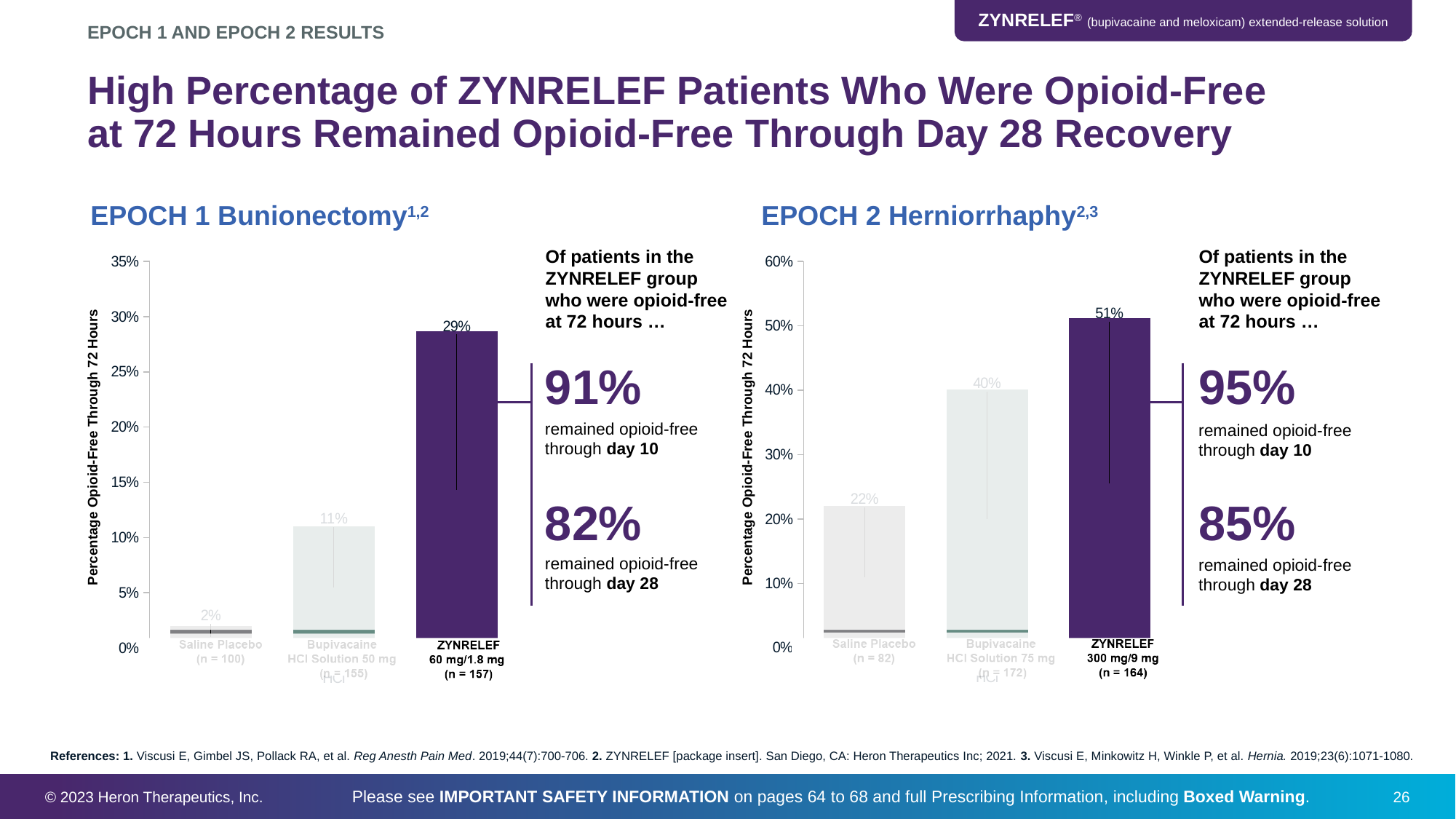
In the EPOCH 1 Bunionectomy chart, what is the difference between the ZYNRELEF group and the Bupivacaine HCl Solution 50 mg group? 18% In the EPOCH 2 Herniorrhaphy chart, what is the difference between the ZYNRELEF group and the Saline Placebo group? 29% In the EPOCH 2 Herniorrhaphy chart, which group has the lowest percentage opioid-free through 72 hours? Saline Placebo In the EPOCH 1 Bunionectomy chart, which group has the highest percentage opioid-free through 72 hours? ZYNRELEF 60 mg/1.8 mg How many groups are plotted in the EPOCH 1 Bunionectomy chart? 3 In the EPOCH 2 Herniorrhaphy chart, which is larger: the Bupivacaine HCl Solution 75 mg value or the Saline Placebo value? Bupivacaine HCl Solution 75 mg What is the y-axis label of the EPOCH 1 Bunionectomy chart? Percentage Opioid-Free Through 72 Hours In the EPOCH 2 Herniorrhaphy chart, what percentage of the ZYNRELEF 300 mg/9 mg group were opioid-free through 72 hours? 51% In the EPOCH 1 Bunionectomy chart, what percentage of patients in the ZYNRELEF 60 mg/1.8 mg group were opioid-free through 72 hours? 29% In the EPOCH 2 Herniorrhaphy chart, what is the value for the Bupivacaine HCl Solution 75 mg group? 40% In the EPOCH 1 Bunionectomy chart, what is the value for the Saline Placebo group? 2% What type of chart is the EPOCH 2 Herniorrhaphy chart? Bar chart